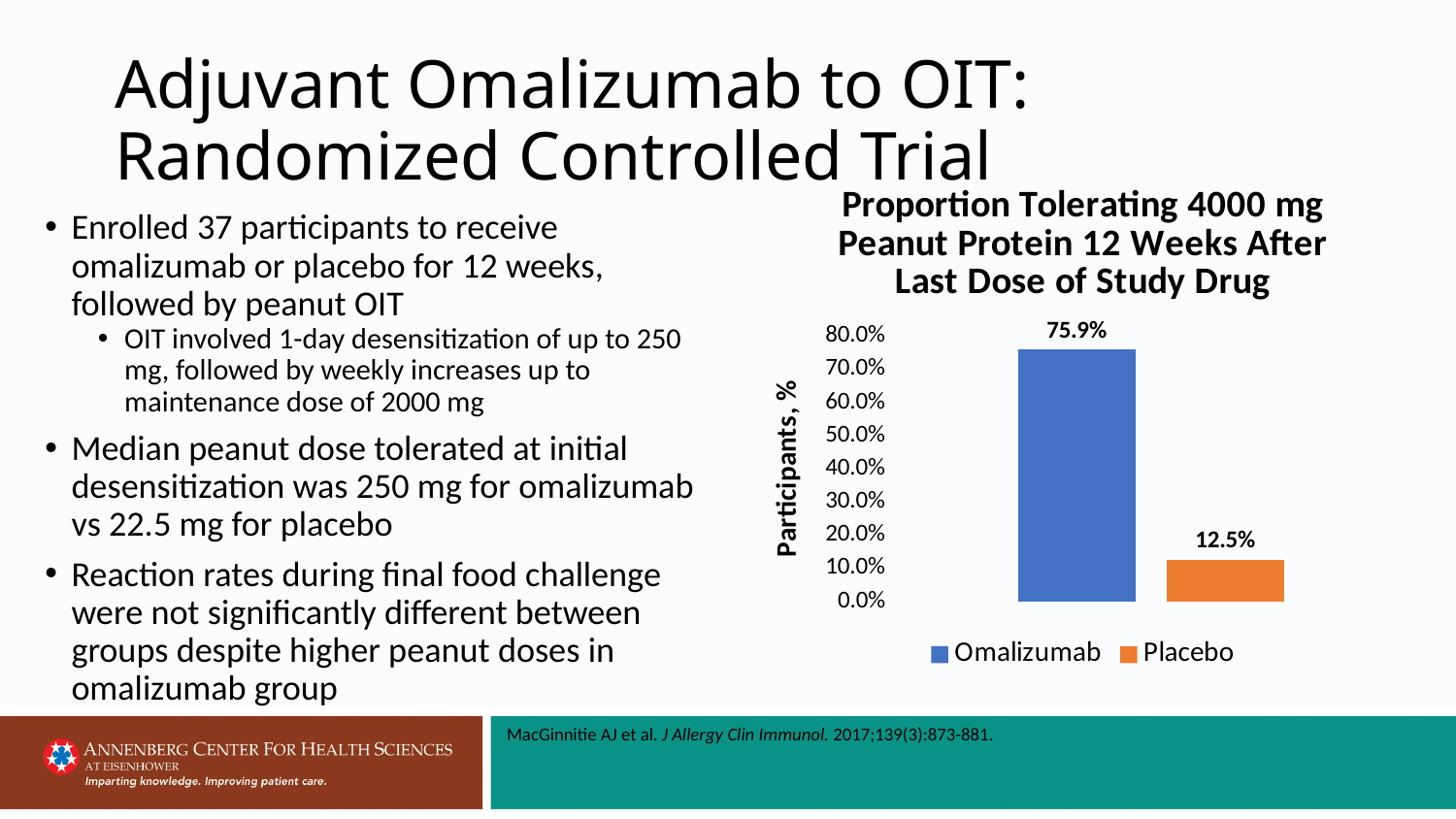
Which group has the higher proportion tolerating 4000 mg peanut protein? Omalizumab What is the difference between the Omalizumab and Placebo values? 63.4% What is the label of the vertical axis of the chart? Participants, % What kind of chart is shown on the slide? Bar chart Is the value for Omalizumab greater or less than 70.0%? greater How many entries does the legend list? 2 What is the value for Placebo in the chart? 12.5% How many bars are plotted in the chart? 2 What is the value for Omalizumab in the chart? 75.9% Which group has the lower proportion tolerating 4000 mg peanut protein? Placebo What colour is the Placebo bar in the chart? Orange Is the value for Placebo greater or less than 20.0%? less